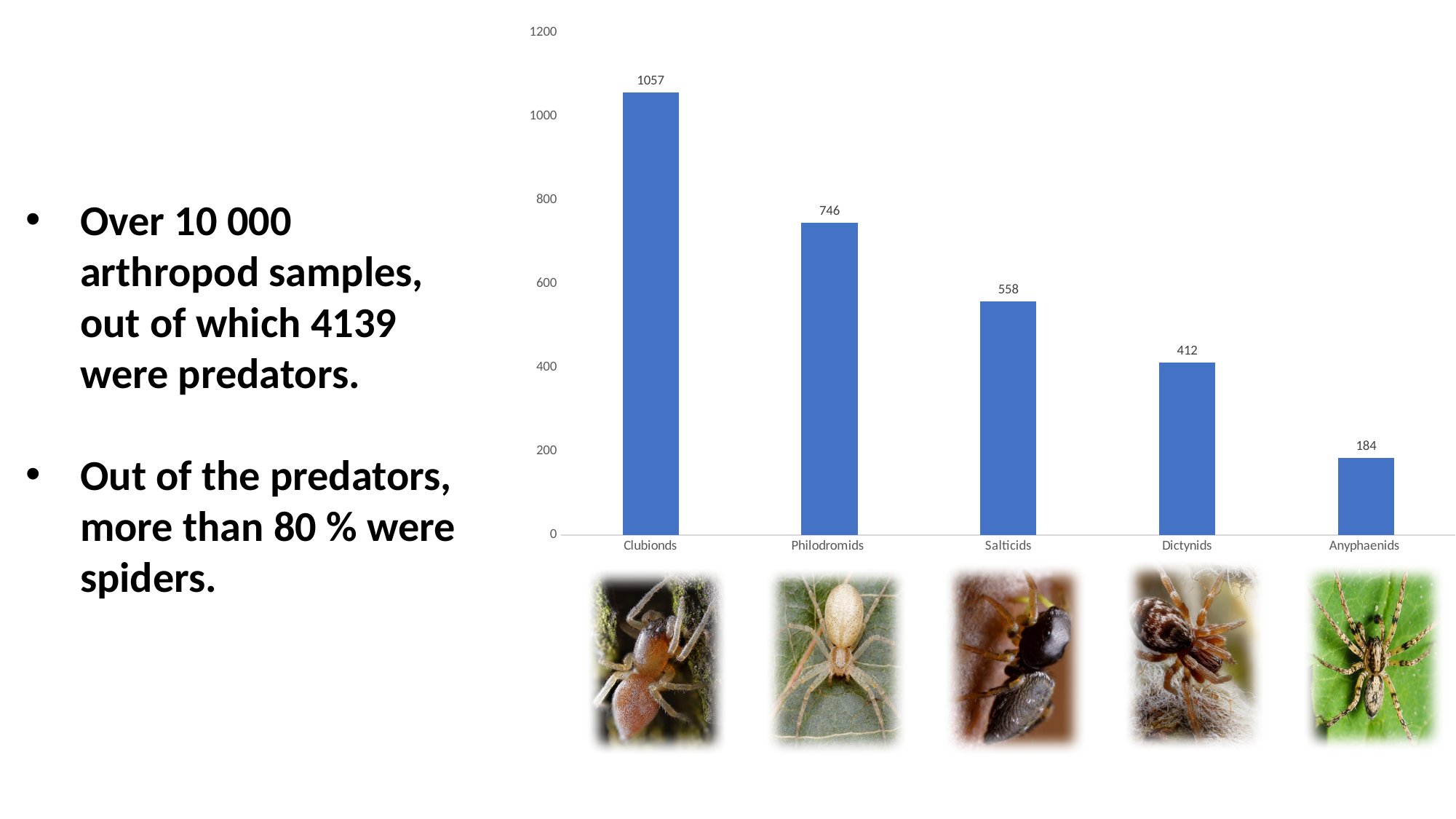
What is the value for Anyphaenids? 184 What is the value for Salticids? 558 What kind of chart is shown on the slide? Bar chart What is the value for Clubionds? 1057 Do the values rise or fall from left to right along the x axis? Fall What is the value for Dictynids? 412 How many categories are shown on the x axis? 5 What is the difference between the values for Clubionds and Philodromids? 311 Which category has the lowest value? Anyphaenids What is the value for Philodromids? 746 Which is larger, the value for Salticids or the value for Dictynids? Salticids Which category has the highest value? Clubionds